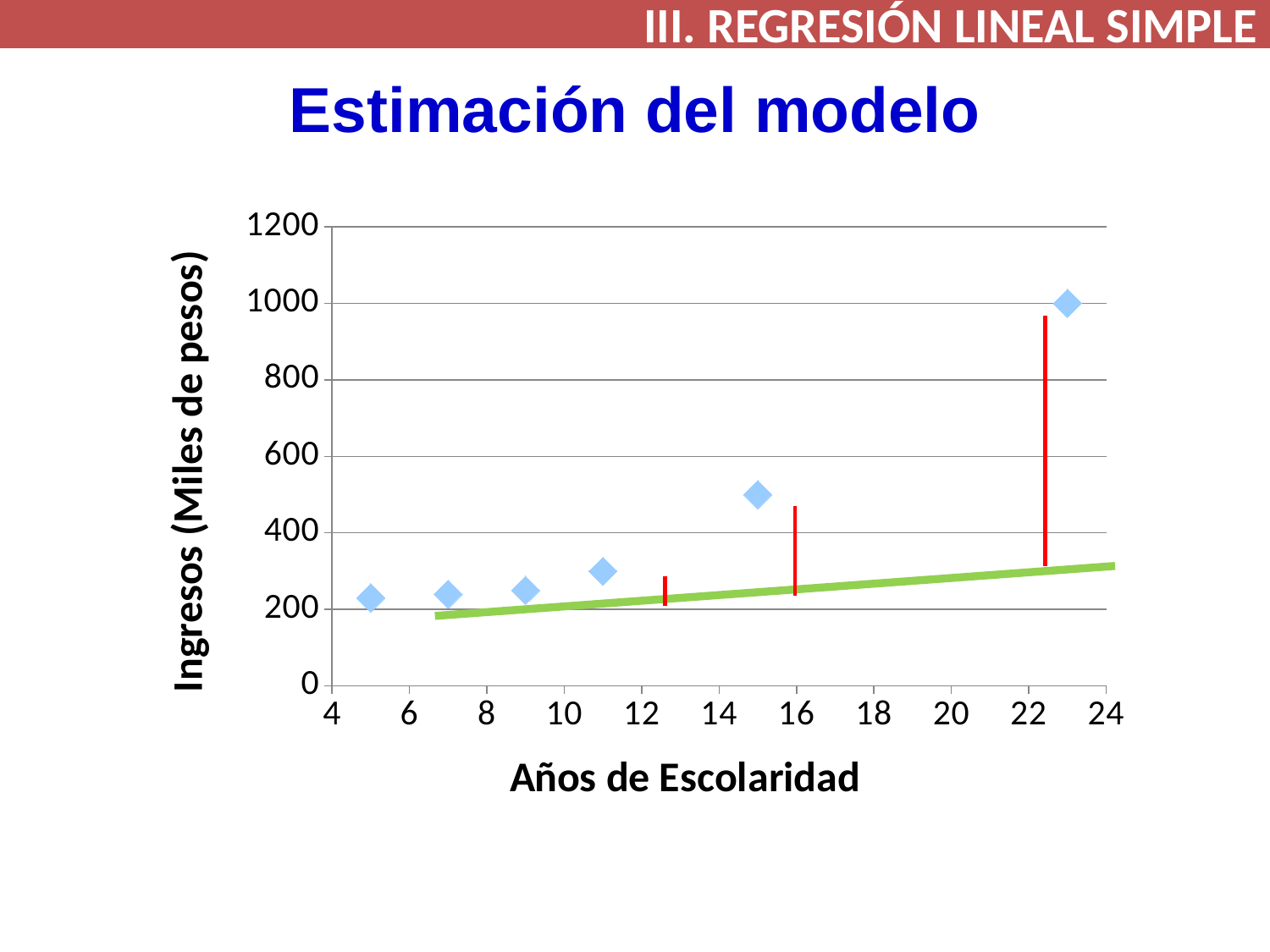
Do the plotted Ingresos values rise or fall as Años de Escolaridad increases? rise How many data points are plotted in the chart? 6 Is the Ingresos value for 23 years of schooling greater or less than 800? greater What is the title of the y axis? Ingresos (Miles de pesos) What is the title of the x axis? Años de Escolaridad Is the Ingresos value for 5 years of schooling greater or less than 400? less Which has a higher Ingresos value: 15 years of schooling or 11 years of schooling? 15 years Is the Ingresos value for 15 years of schooling greater or less than 400? greater What kind of chart is shown on the slide? scatter chart At which value of Años de Escolaridad is the plotted Ingresos highest? 23